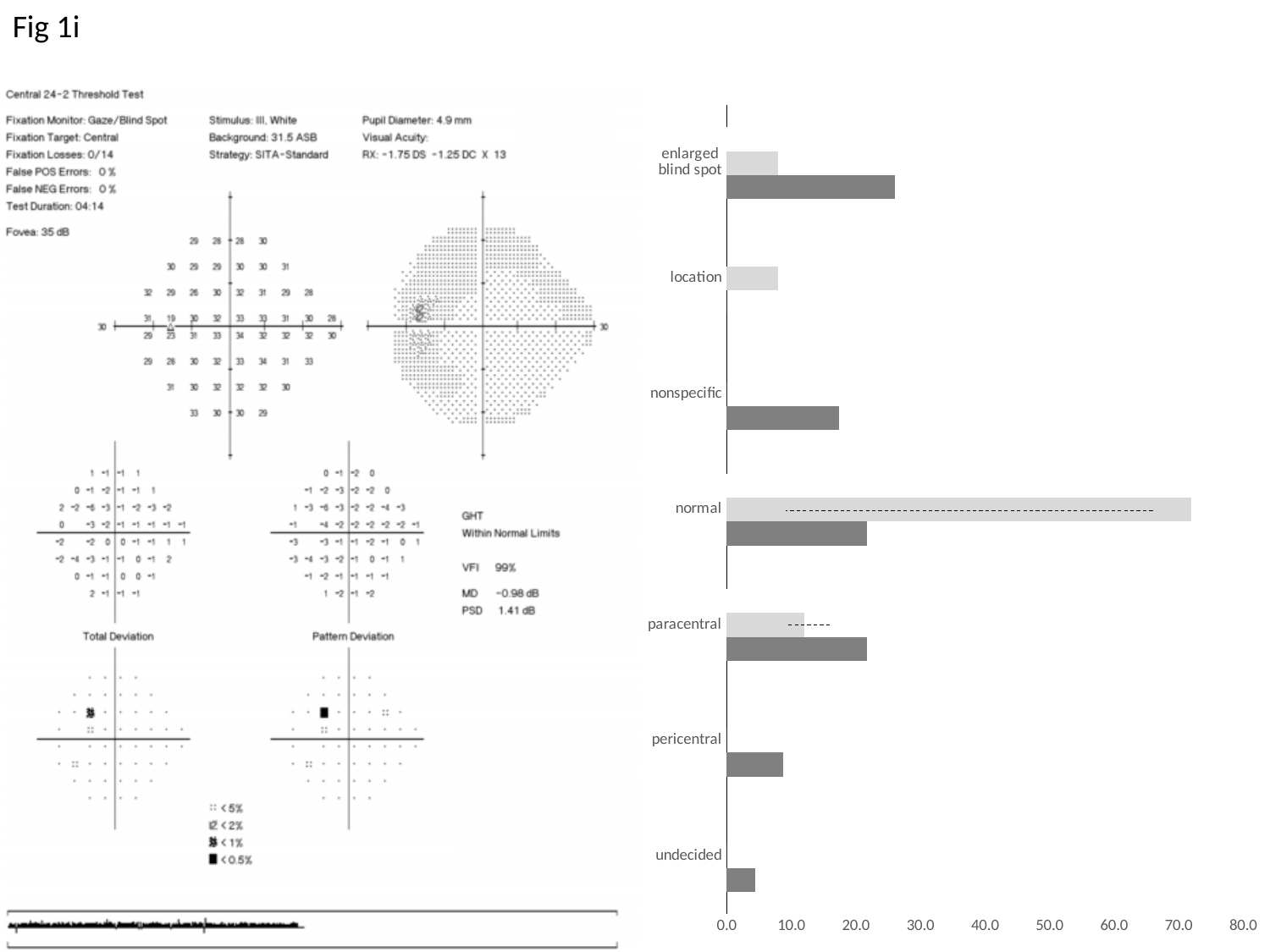
Which is larger in the bar chart: the dark grey bar for nonspecific or the dark grey bar for pericentral? nonspecific Which category has the longest dark grey bar in the bar chart? enlarged blind spot Is the dark grey bar for enlarged blind spot greater or less than 20.0? greater How many categories are listed on the vertical axis of the bar chart? 7 Which category has the longest light grey bar in the bar chart? normal What kind of chart is shown on the right side of the slide? bar chart Is the dark grey bar for nonspecific greater or less than 10.0? greater Is the dark grey bar for undecided greater or less than 10.0? less What is the highest value shown on the horizontal axis of the bar chart? 80.0 Which category has the shortest dark grey bar in the bar chart? undecided Which is larger in the bar chart: the light grey bar for paracentral or the dark grey bar for paracentral? dark grey bar